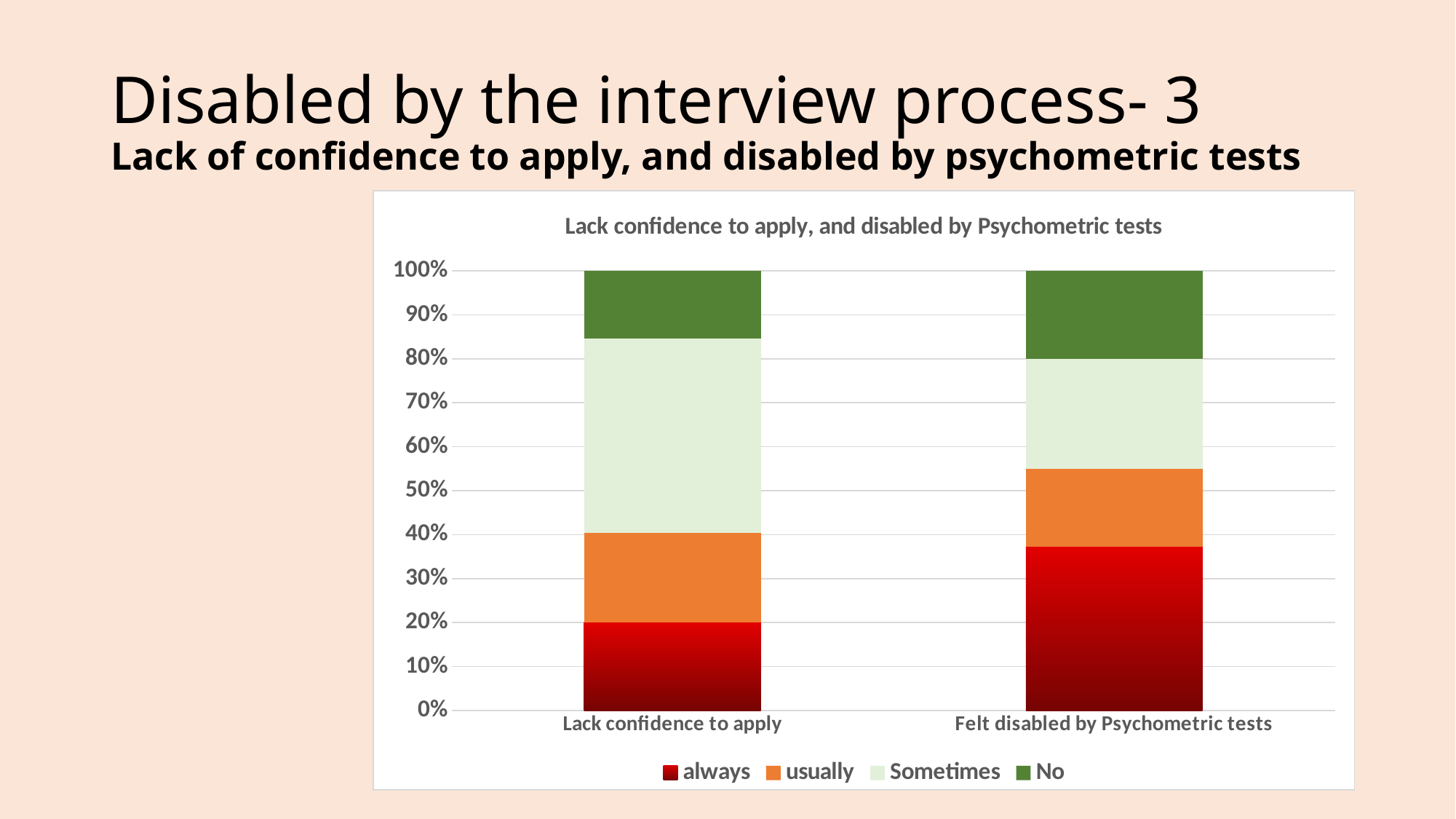
How many categories are shown on the x axis of the chart? 2 Is the 'No' share for 'Lack confidence to apply' greater or less than 20%? less Which category has the larger 'Sometimes' share: 'Lack confidence to apply' or 'Felt disabled by Psychometric tests'? Lack confidence to apply What kind of chart is shown on the slide? Stacked bar chart What is the title of the chart? Lack confidence to apply, and disabled by Psychometric tests Is the 'always' share for 'Felt disabled by Psychometric tests' greater or less than 30%? greater Which legend entry is shown in dark green? No Which response makes up the largest segment of the 'Lack confidence to apply' bar? Sometimes Is the 'Sometimes' share for 'Lack confidence to apply' greater or less than 40%? greater Which category has the larger 'always' share: 'Lack confidence to apply' or 'Felt disabled by Psychometric tests'? Felt disabled by Psychometric tests How many series does the chart's legend list? 4